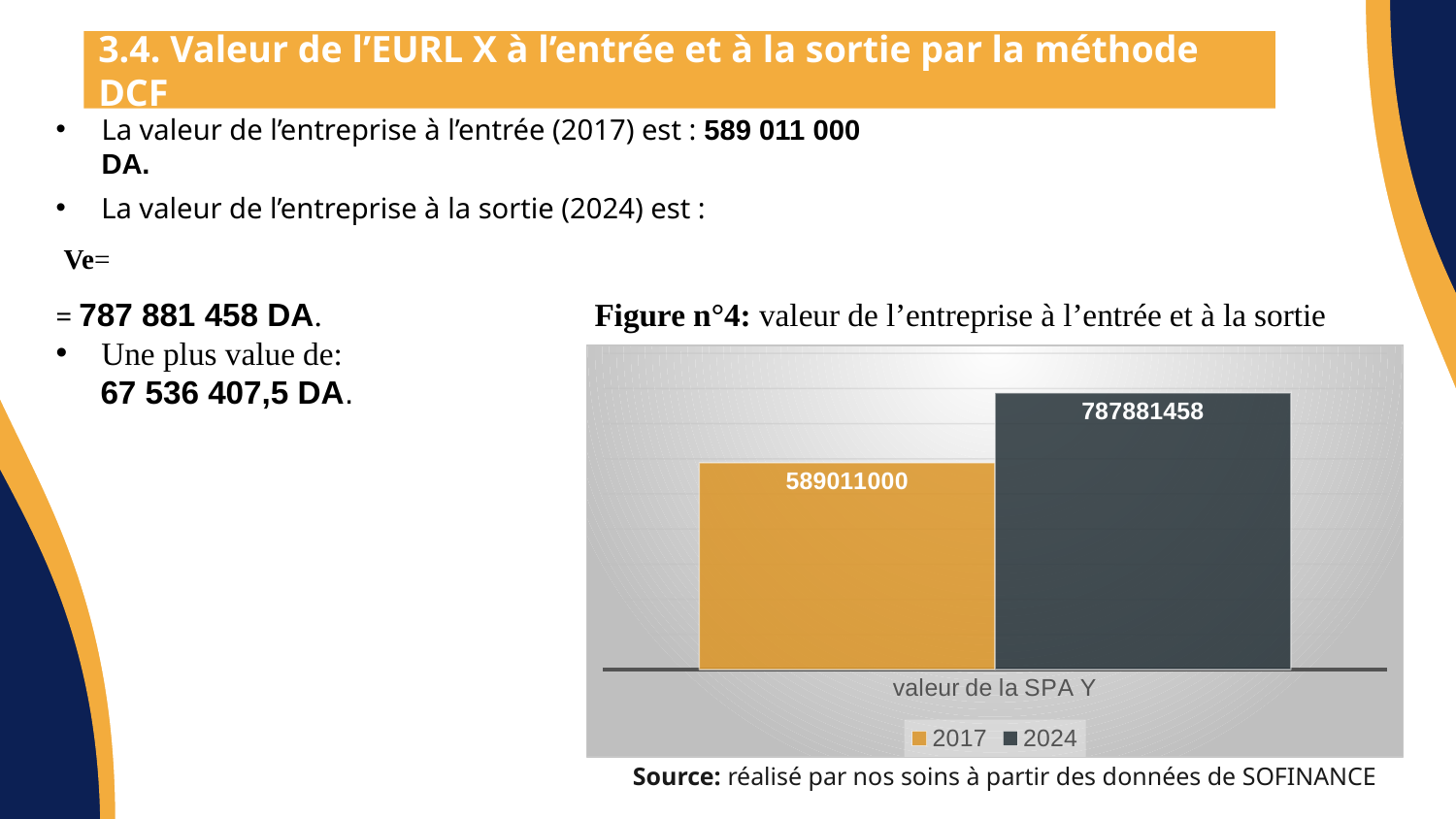
Which series shows the highest value in the chart? 2024 What is the value for the 2017 series in the chart? 589011000 What is the category label shown on the x axis of the chart? valeur de la SPA Y Which series is drawn in orange in the chart? 2017 How many series does the chart legend list? 2 Which series shows the lowest value in the chart? 2017 What is the difference between the 2024 value and the 2017 value in the chart? 198870458 What kind of chart is shown on the slide? bar chart What is the value for the 2024 series in the chart? 787881458 How many categories are shown on the x axis of the chart? 1 Which series has the higher value, 2017 or 2024? 2024